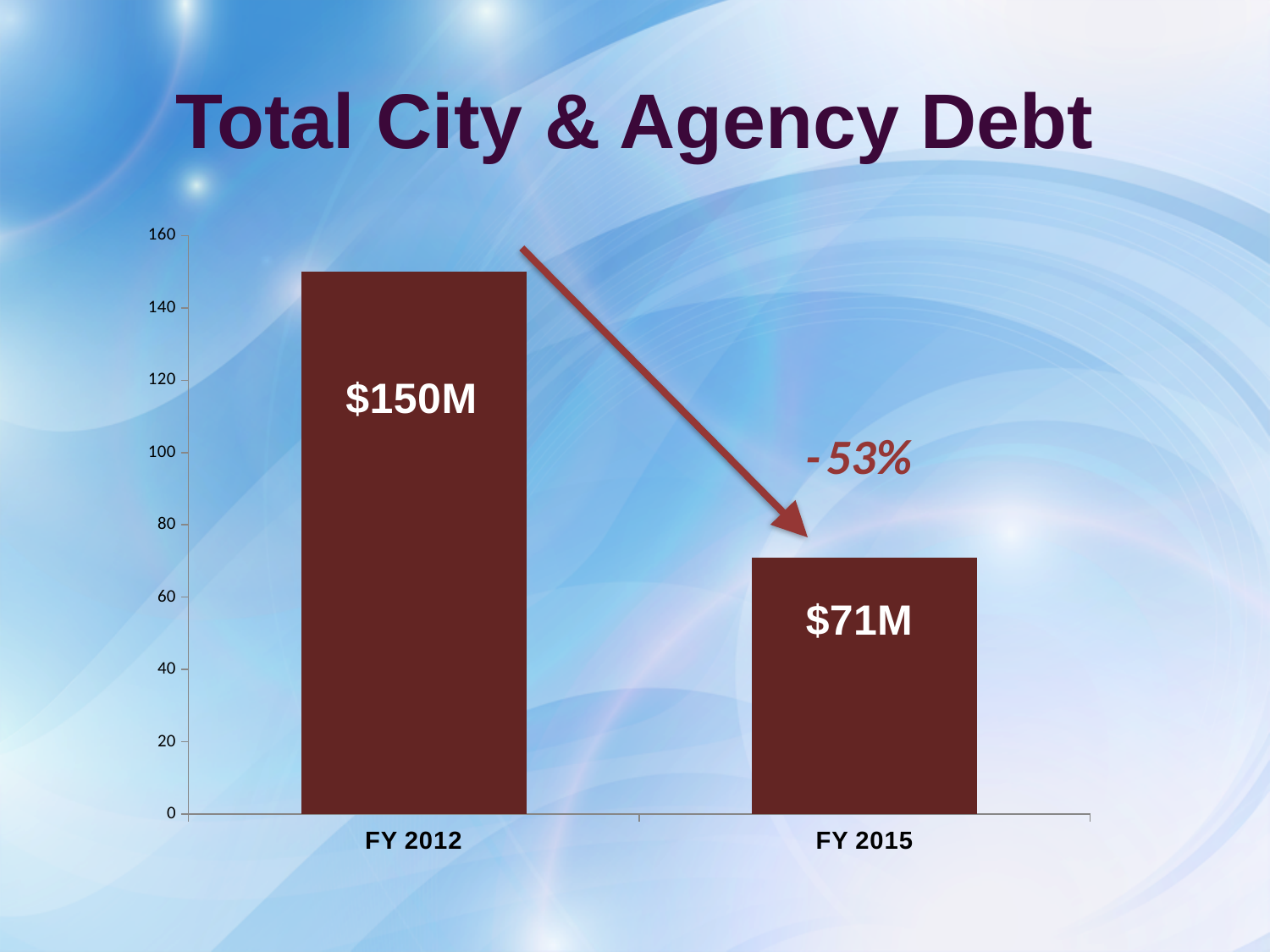
Which is larger, the value for FY 2012 or FY 2015? FY 2012 What kind of chart is shown? bar chart What is the value for FY 2015? $71M How many categories are shown on the x axis? 2 Is the value for FY 2015 greater or less than 80? less Is the value for FY 2012 greater or less than 140? greater Which category has the highest value? FY 2012 What is the value for FY 2012? $150M Do the values rise or fall from FY 2012 to FY 2015? fall What is the title of the chart? Total City & Agency Debt What is the difference between the FY 2012 and FY 2015 values? $79M Which category has the lowest value? FY 2015